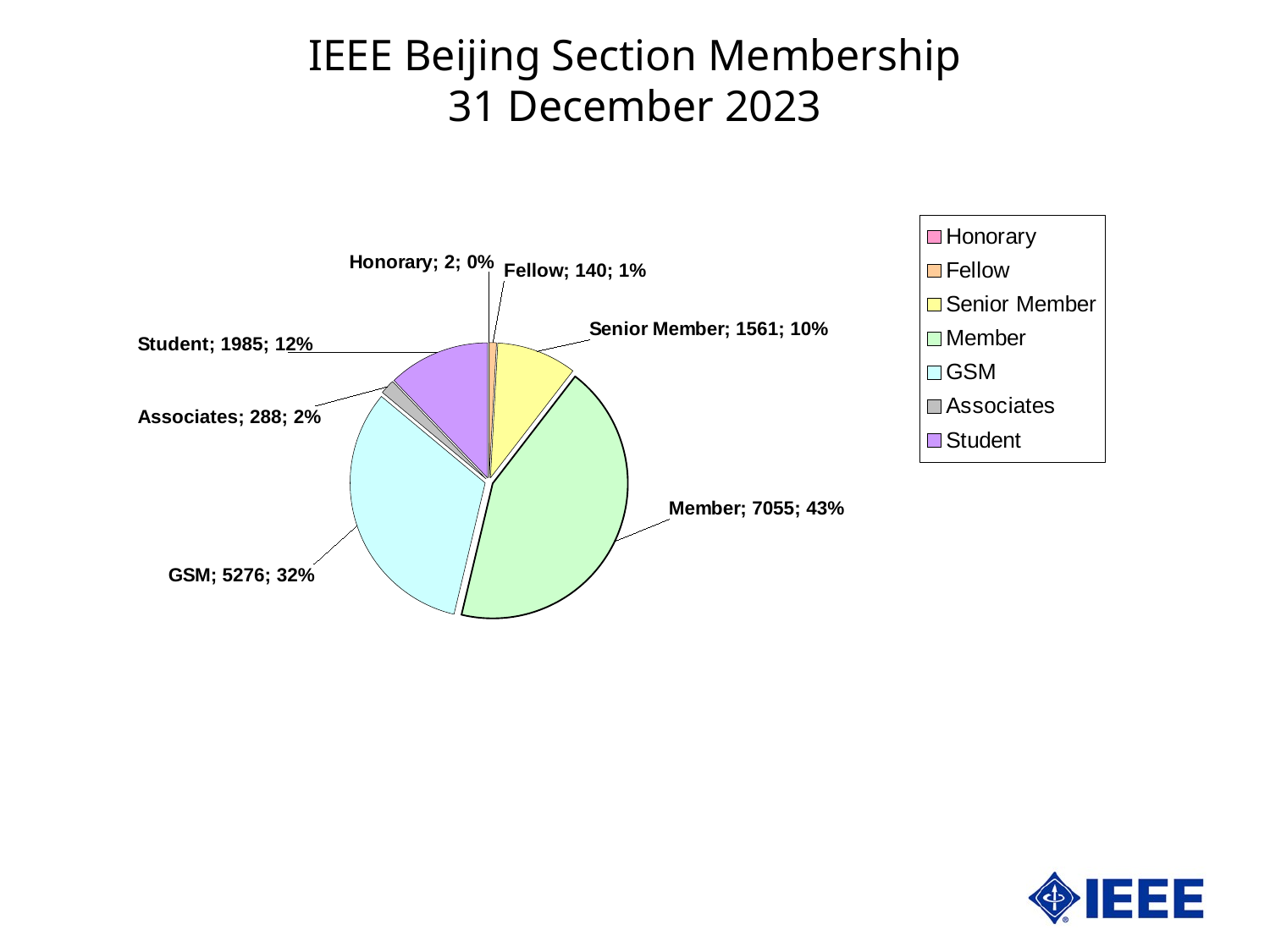
What is the value for GSM? 5276 What is the difference between the Member and GSM values? 1779 How many membership categories are shown in the pie chart? 7 What is the value for Member? 7055 Which is larger, Student or Associates? Student How many entries does the legend list? 7 What share of the pie does Student represent? 12% What is the title of the chart? IEEE Beijing Section Membership 31 December 2023 What kind of chart is shown on the slide? Pie chart What is the value for Senior Member? 1561 Which category has the largest slice? Member Which category has the smallest slice? Honorary